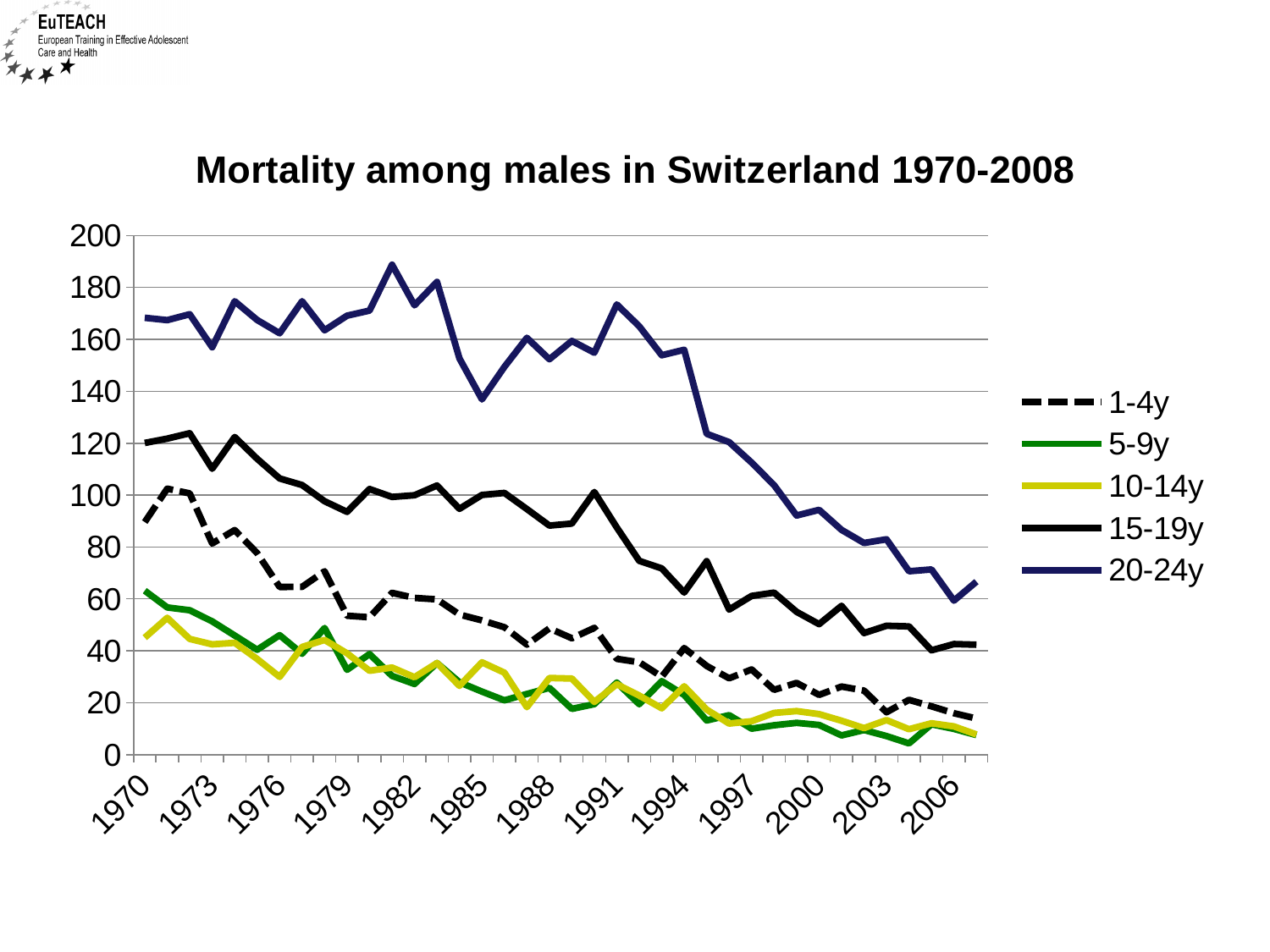
Is the value for the 15-19y series in 2006 greater or less than 60? less Which age group has the lowest mortality in 1970? 10-14y Does the 20-24y series overall rise or fall from 1970 to 2008? fall What kind of chart is shown on the slide? line chart Is the value for the 20-24y series in 1970 greater or less than 160? greater Is the value for the 15-19y series in 1970 greater or less than 100? greater How many series does the legend list? 5 Which series is drawn with a dashed line? 1-4y In 1970, which is larger: the 1-4y value or the 5-9y value? 1-4y Which age group has the highest mortality in 1970? 20-24y What is the title of the chart? Mortality among males in Switzerland 1970-2008 How many year labels are shown on the x axis? 13